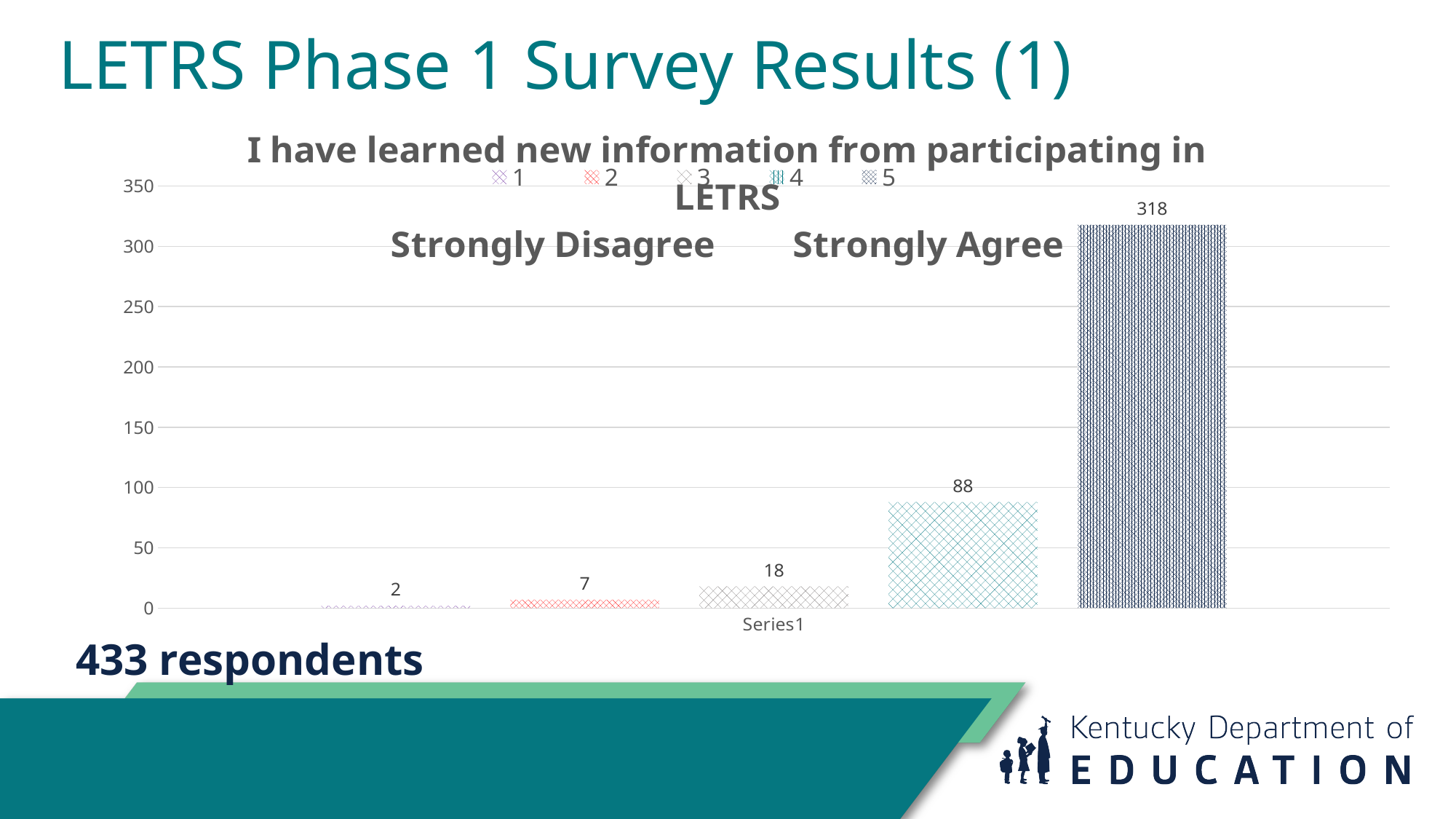
What value is shown for series 1 in the chart? 2 What value is shown for series 3 in the chart? 18 Is the value for series 5 greater or less than 300? greater Which series has the lowest value in the chart? 1 What is the difference between the values for series 5 and series 4? 230 What value is shown for series 5 in the chart? 318 Which is larger, the value for series 2 or the value for series 3? 3 How many series does the legend list? 5 What value is shown for series 4 in the chart? 88 Which series has the highest value in the chart? 5 What kind of chart is shown on the slide? Bar chart What is the title of the chart? I have learned new information from participating in LETRS